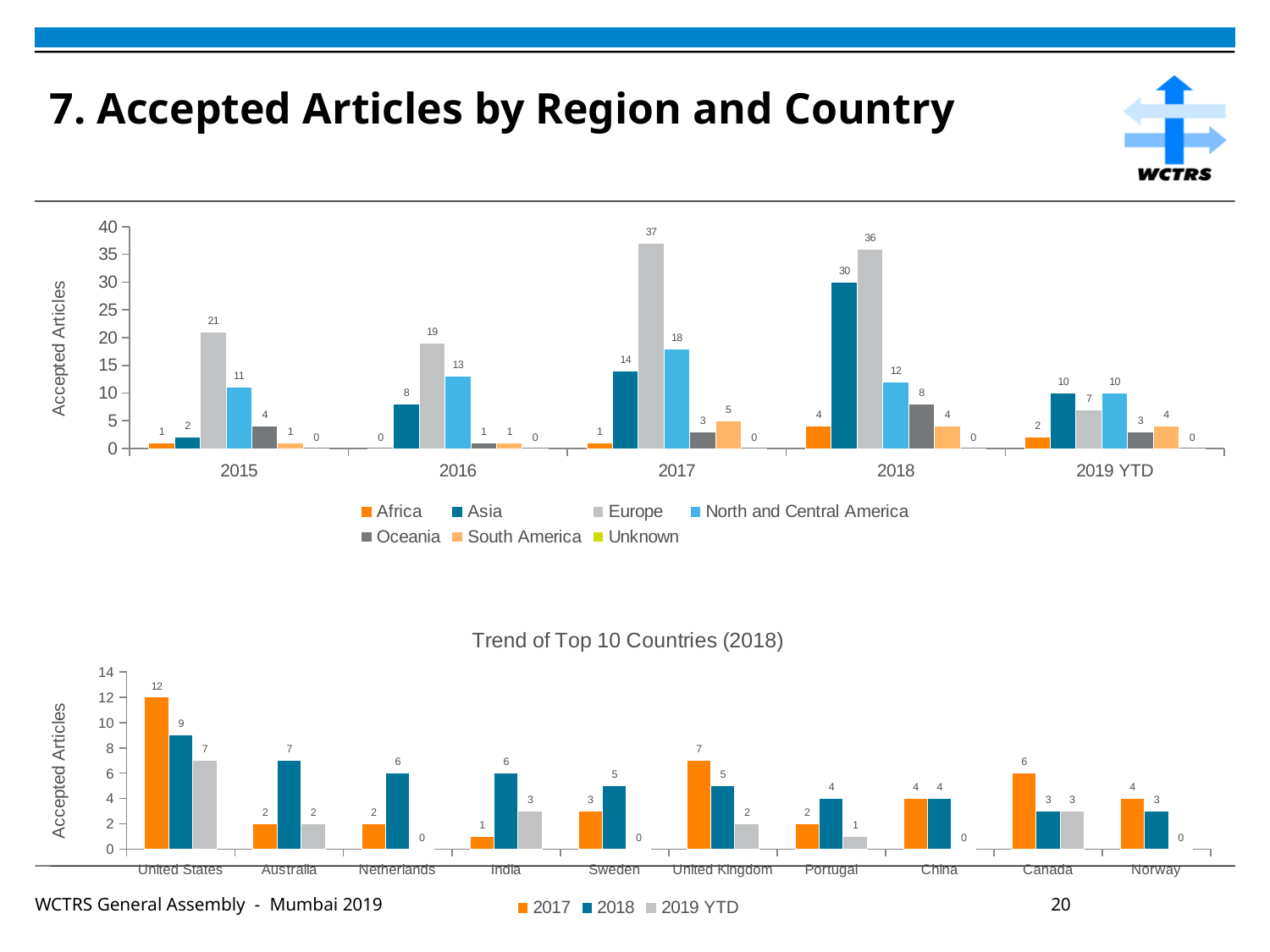
In the top chart, which region had the most accepted articles in 2015? Europe In the chart 'Trend of Top 10 Countries (2018)', what is the difference between the United Kingdom's 2017 and 2018 values? 2 In the top chart, what is the difference between Europe and Asia in 2018? 6 In the top chart, how many accepted articles did Europe have in 2017? 37 In the top chart, which is larger in 2016: Asia or North and Central America? North and Central America In the chart 'Trend of Top 10 Countries (2018)', which country had the highest 2018 value? United States In the chart 'Trend of Top 10 Countries (2018)', how many accepted articles did the United States have in 2017? 12 In the top chart, how many accepted articles did Asia have in 2018? 30 In the top chart, how does the value for Europe change from 2018 to 2019 YTD? It falls What type of chart is 'Trend of Top 10 Countries (2018)'? Bar chart In the chart 'Trend of Top 10 Countries (2018)', how many countries are shown on the x axis? 10 How many series does the legend of the top chart list? 7